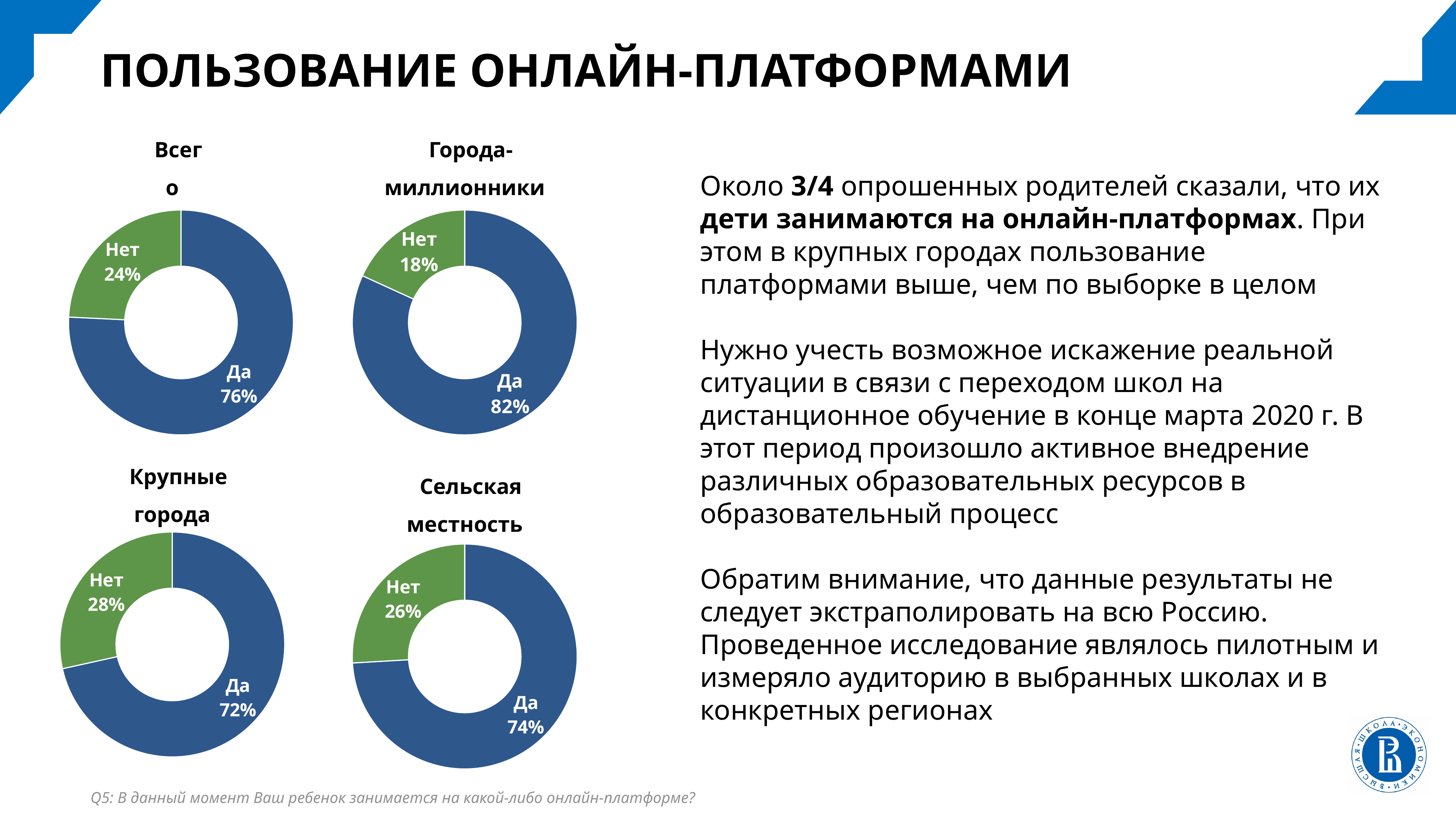
In the "Всего" chart, what colour is the "Нет" slice? Green In the "Сельская местность" chart, what is the value for "Нет"? 26% Across the four charts, which group has the highest "Да" share? Города-миллионники In the "Крупные города" chart, what is the difference between the "Да" and "Нет" shares? 44% In the "Всего" chart, what share of respondents answered "Да"? 76% In the "Города-миллионники" chart, which slice is larger, "Да" or "Нет"? Да How many slices does the "Сельская местность" chart have? 2 What kind of chart is the "Всего" chart? Pie (donut) chart How many donut charts are shown on the slide? 4 In the "Крупные города" chart, what is the value for "Да"? 72% Across the four charts, which group has the lowest "Да" share? Крупные города In the "Города-миллионники" chart, what is the value for "Нет"? 18%